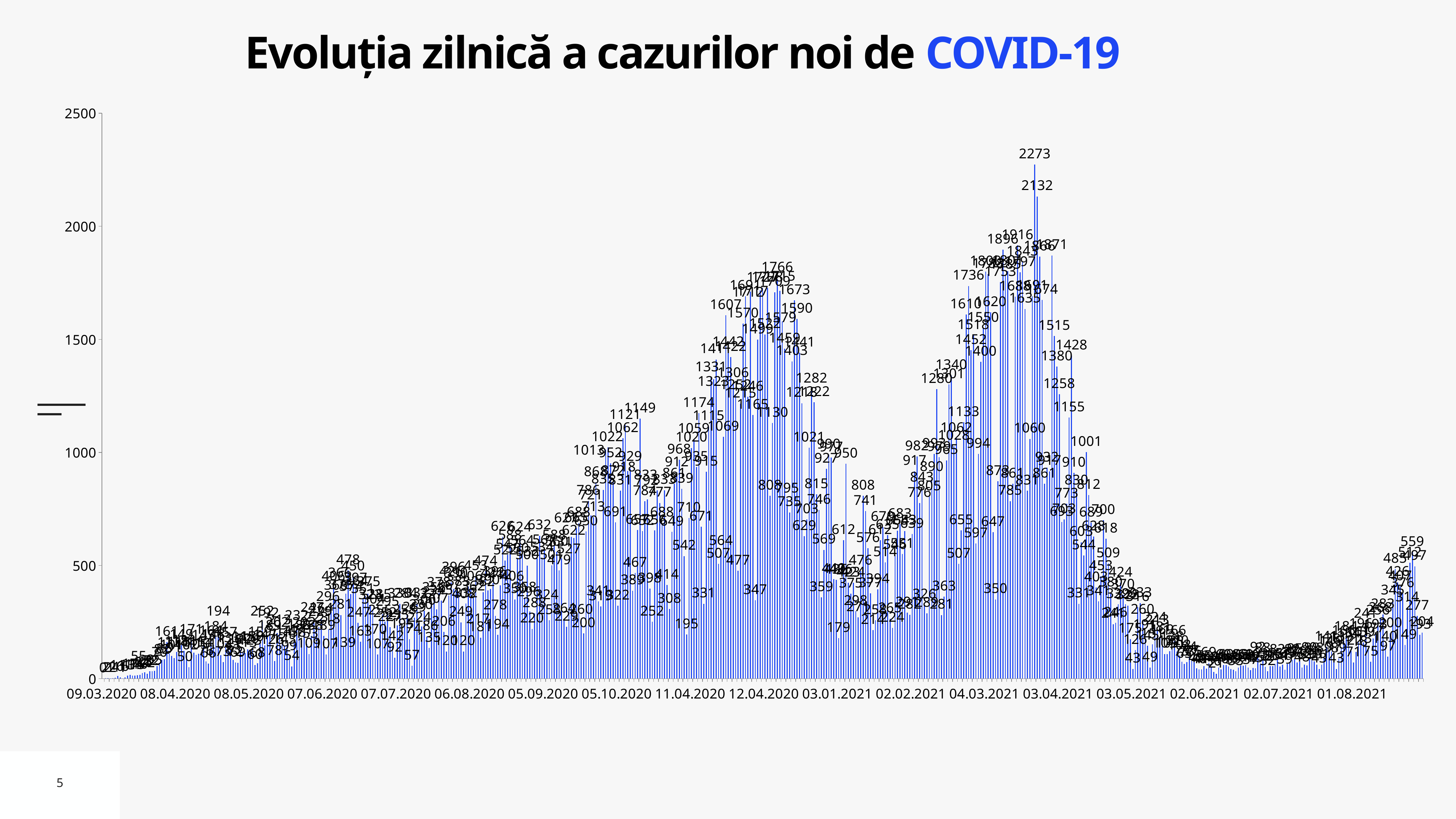
What is the difference between the two highest labelled values, 2273 and 2132? 141 What is the first date label on the horizontal axis? 09.03.2020 What is the last date label on the horizontal axis? 01.08.2021 What is the highest value shown on the vertical axis? 2500 Is the tallest bar on the chart greater or less than 2000? greater What is the highest value labelled on the chart? 2273 Are the bars around the 02.07.2021 tick greater or less than 500? less Which peak is taller: the one near 03.04.2021 labelled 2273 or the one near 12.04.2020 labelled 1766? the one near 03.04.2021 (2273) What is the title of the chart? Evoluția zilnică a cazurilor noi de COVID-19 How many date labels are shown on the horizontal axis? 18 What is the second-highest value labelled on the chart, just below the 2273 peak? 2132 What kind of chart is shown on the slide? bar chart